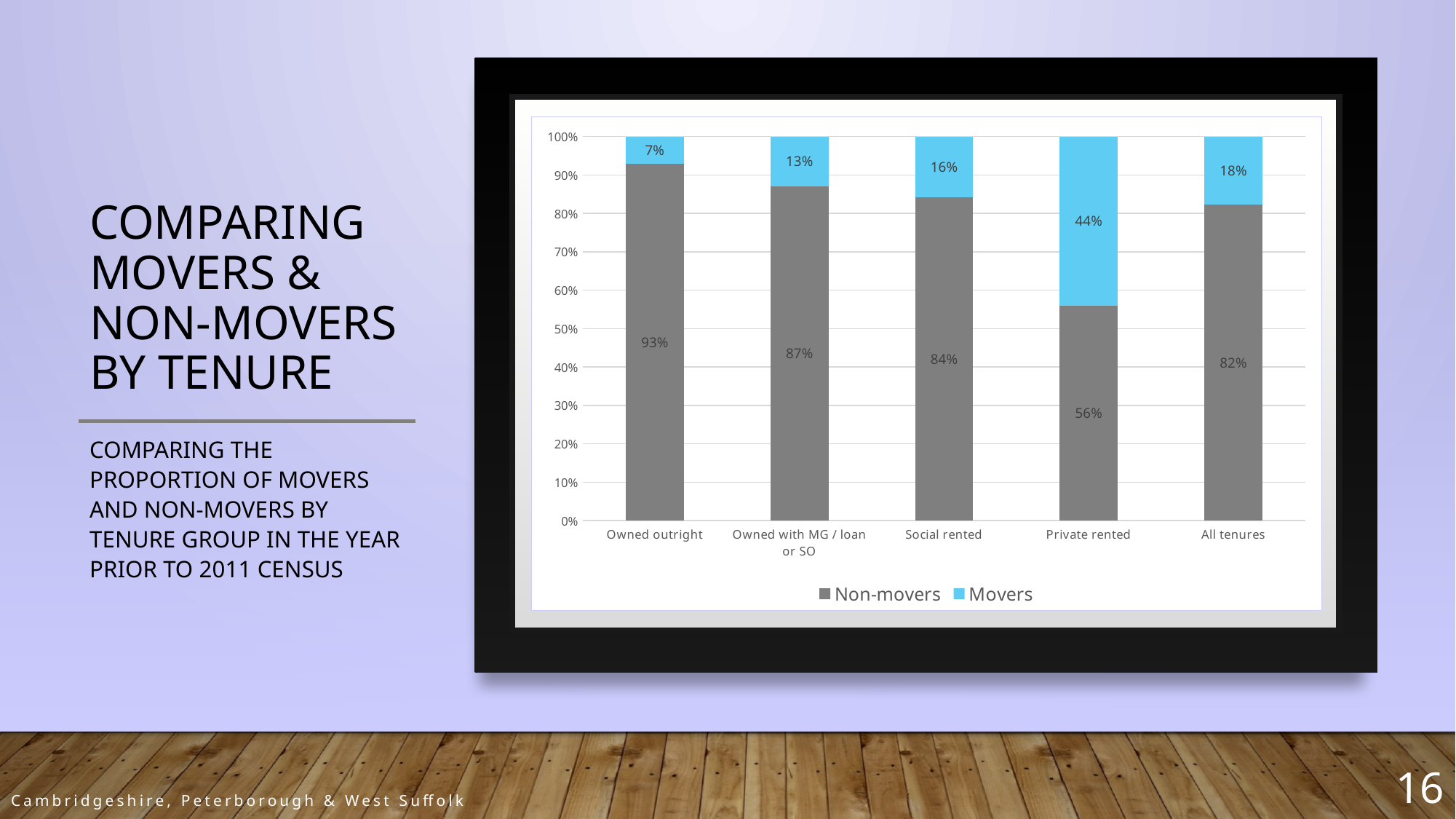
Which colour represents Movers in the chart? Light blue What is the total of the Non-movers and Movers segments for Private rented? 100% What is the Movers value for All tenures? 18% What percentage of Private rented households were Movers? 44% Which tenure group has the highest proportion of Movers? Private rented How many tenure categories are shown on the x axis? 5 What kind of chart is shown on the slide? Stacked bar chart Which tenure group has the lowest proportion of Non-movers? Private rented Which is larger: the Non-movers share for Owned with MG / loan or SO, or for Social rented? Owned with MG / loan or SO How many series does the legend list? 2 What is the difference between the Movers percentage for Social rented and for Owned outright? 9% What percentage of Owned outright households were Non-movers? 93%